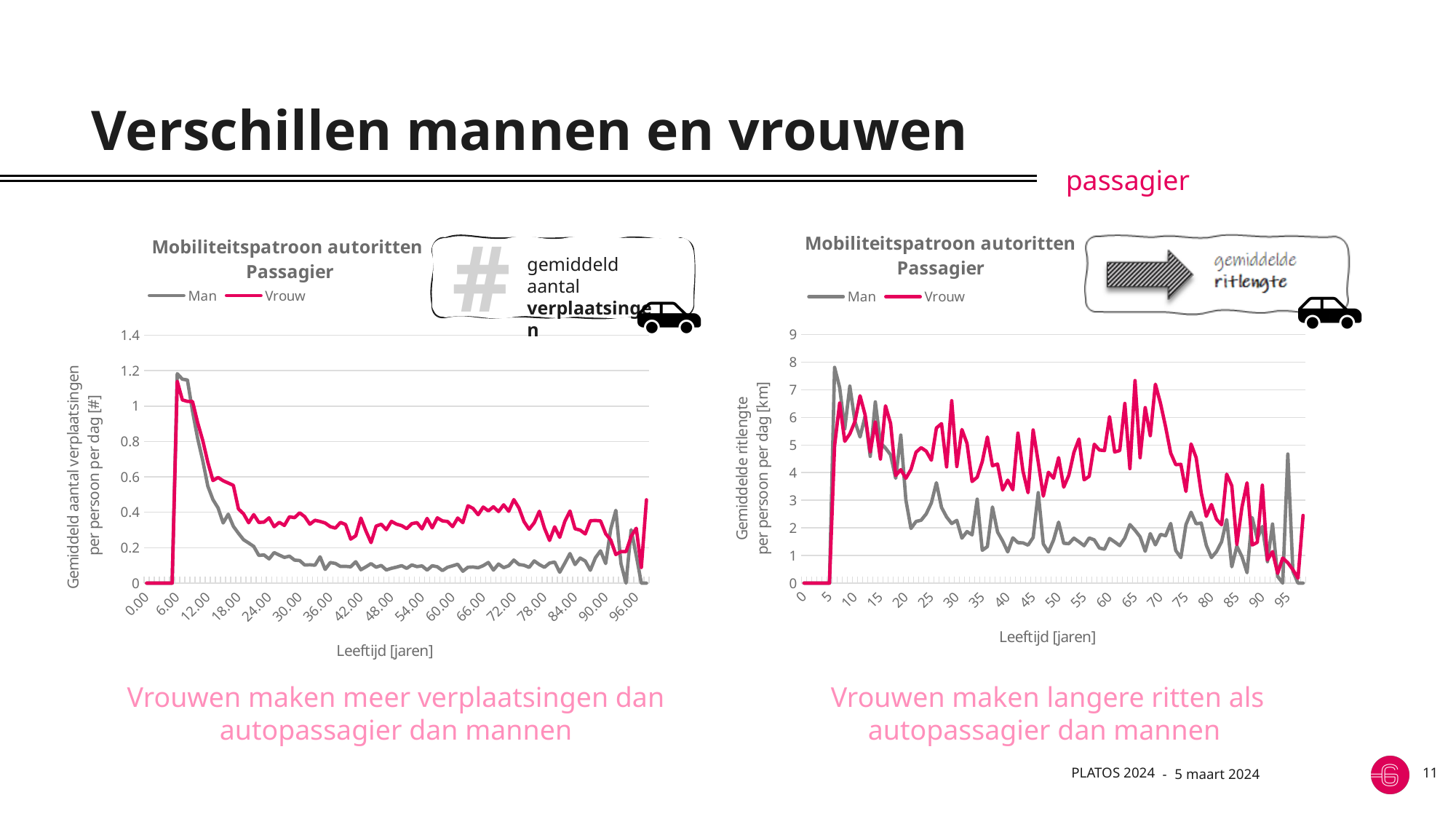
How many series does the legend of the right chart list? 2 In the left chart, is the value for Man at age 60 greater or less than 0.2? less What are the two series named in the legend of the left chart? Man and Vrouw In the right chart, is the value for Man at age 40 greater or less than 2? less In the right chart, is the peak value of the Man line greater or less than 7? greater What kind of chart is the left chart on the slide? line chart In the left chart, which series has the higher value at age 48, Man or Vrouw? Vrouw In the left chart, does the Man line rise or fall between age 12 and age 36? fall In the right chart, which series has the higher value at age 50, Man or Vrouw? Vrouw What is the y-axis title of the right chart? Gemiddelde ritlengte per persoon per dag [km]